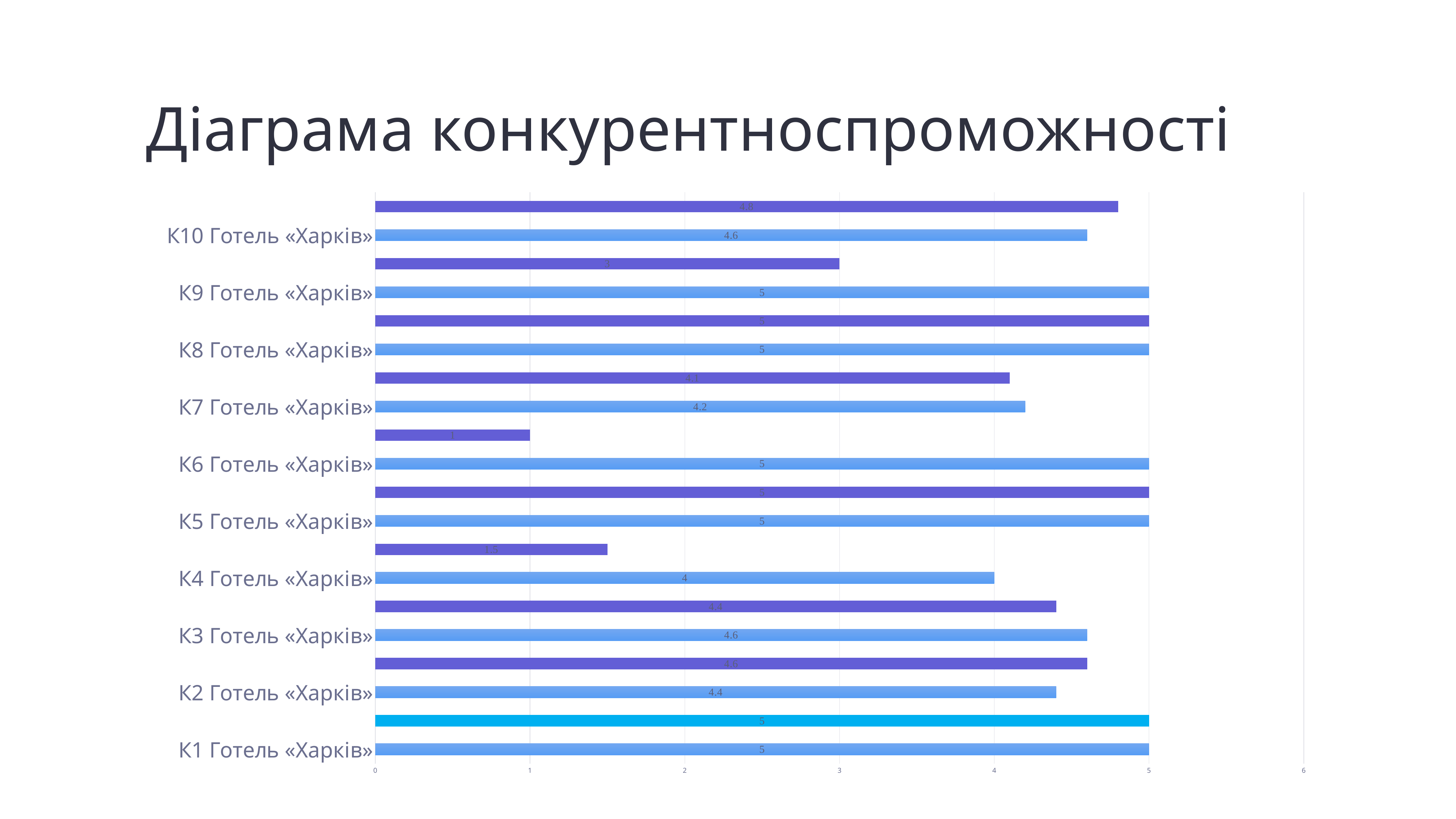
What is the value of the purple bar for K9 Готель «Харків»? 3 What is the value of the light blue bar for K4 Готель «Харків»? 4 What is the title of the chart? Діаграма конкурентноспроможності Which category has the lowest purple bar? K6 Готель «Харків» What is the value of the purple bar for K6 Готель «Харків»? 1 What is the difference between the light blue bar and the purple bar for K4 Готель «Харків»? 2.5 What kind of chart is shown on the slide? bar chart What is the value of the purple bar for K10 Готель «Харків»? 4.8 For K9 Готель «Харків», which is larger: the light blue bar or the purple bar? the light blue bar Is the value of the purple bar for K10 Готель «Харків» greater or less than 4? greater What is the value of the light blue bar for K7 Готель «Харків»? 4.2 How many categories (K1–K10) are shown on the chart? 10